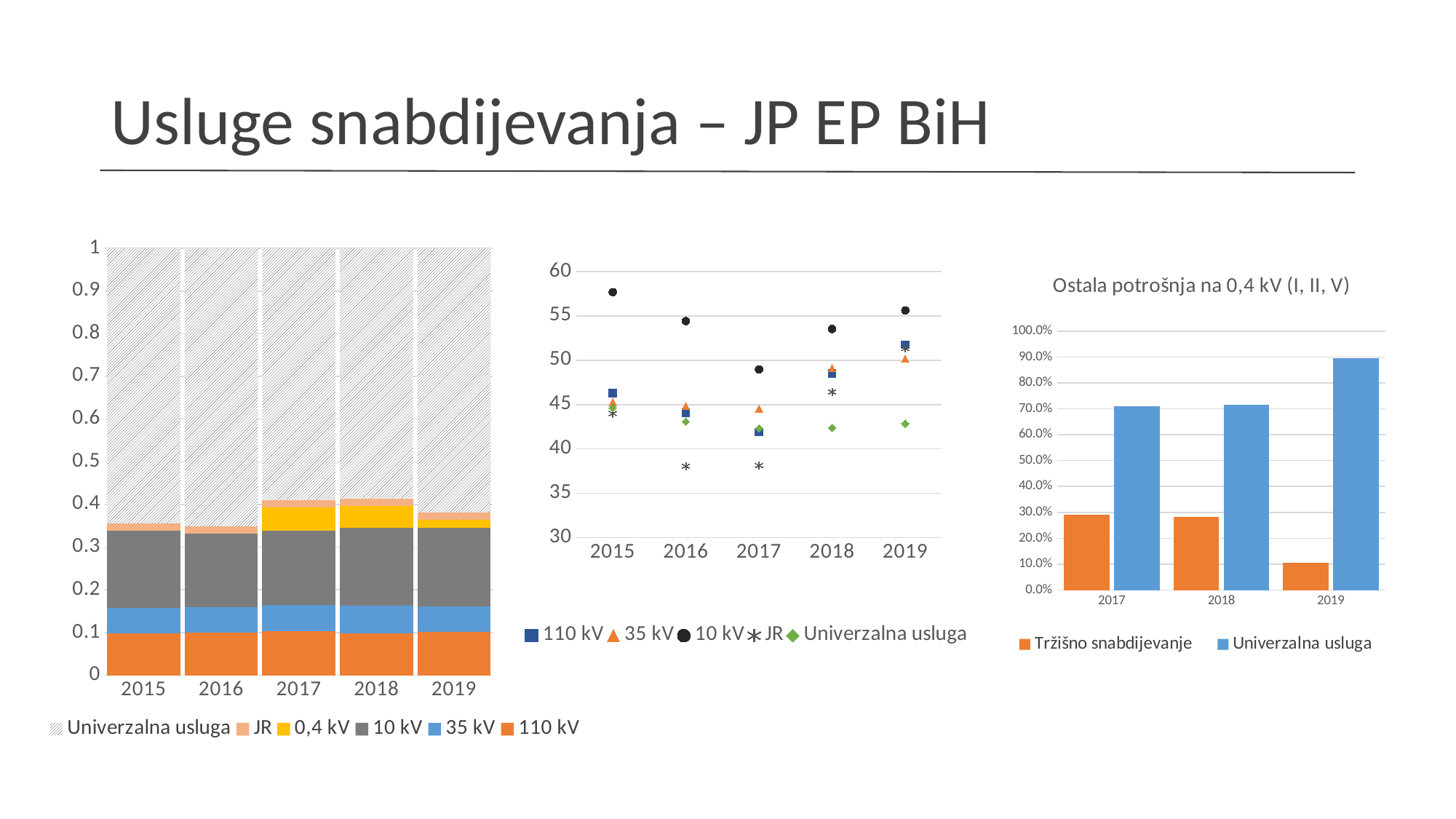
In the chart titled "Ostala potrošnja na 0,4 kV (I, II, V)", in which year is Univerzalna usluga highest? 2019 How many series does the legend of the left stacked chart list? 6 In the middle chart, is the value for 10 kV in 2015 greater or less than 55? greater How many series does the legend of the middle chart list? 5 In the chart titled "Ostala potrošnja na 0,4 kV (I, II, V)", is the value for Univerzalna usluga in 2019 greater or less than 80.0%? greater In the middle chart, in which year is the 10 kV value highest? 2015 In the chart titled "Ostala potrošnja na 0,4 kV (I, II, V)", is the value for Tržišno snabdijevanje in 2019 greater or less than 20.0%? less In the chart titled "Ostala potrošnja na 0,4 kV (I, II, V)", does Tržišno snabdijevanje rise or fall from 2017 to 2019? fall How many years are shown on the x axis of the chart titled "Ostala potrošnja na 0,4 kV (I, II, V)"? 3 How many years are shown on the x axis of the left stacked chart? 5 What kind of chart is the chart on the right titled "Ostala potrošnja na 0,4 kV (I, II, V)"? bar chart In the middle chart, which is larger in 2017: 10 kV or Univerzalna usluga? 10 kV